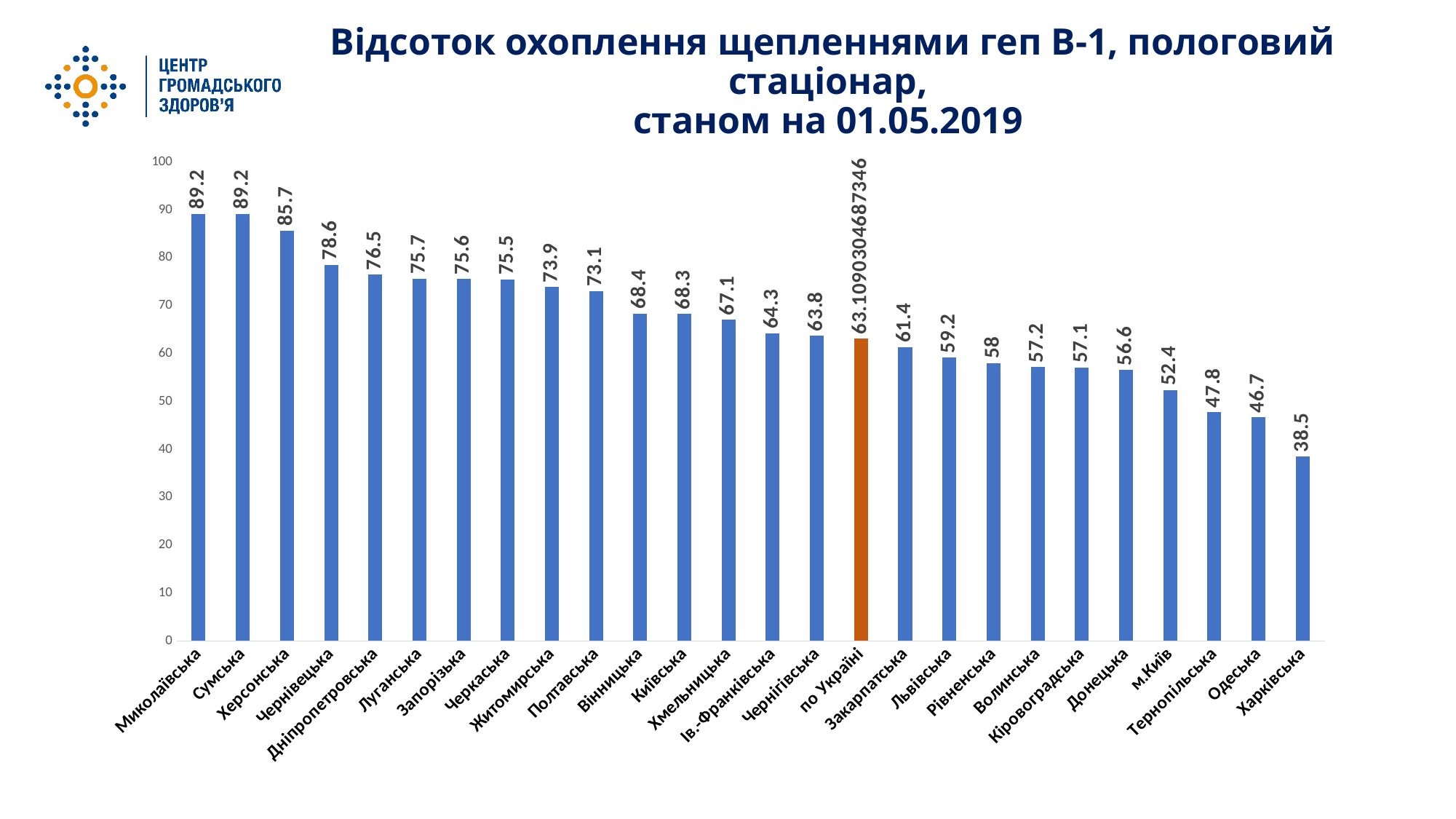
What is the difference between the values for Миколаївська and Харківська? 50.7 How many categories are shown on the x axis? 26 Which category has the lowest value? Харківська What is the value for м.Київ? 52.4 What is the difference between the values for Полтавська and Вінницька? 4.7 Which bar is coloured orange instead of blue? по Україні What is the value for Закарпатська? 61.4 Which is larger, the value for Рівненська or the value for Донецька? Рівненська What kind of chart is shown on the slide? bar chart What is the value for Херсонська? 85.7 Is the value for Одеська greater or less than 50? less What is the value for Чернівецька? 78.6